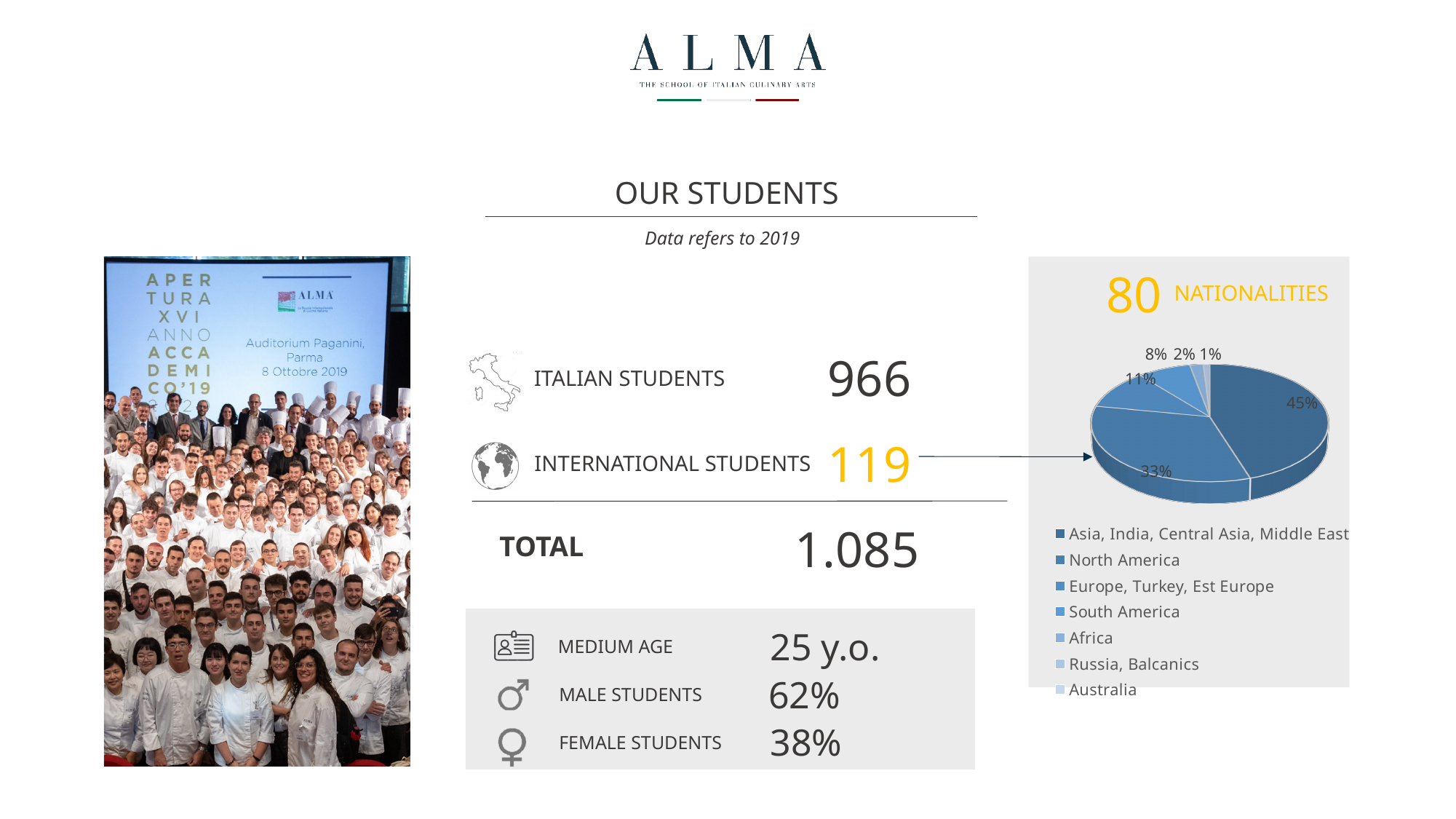
What share of the nationalities pie chart is 'North America'? 33% What is the difference in percentage points between the 'Asia, India, Central Asia, Middle East' slice and the 'North America' slice? 12 Which category has the largest slice in the nationalities pie chart? Asia, India, Central Asia, Middle East What share of the nationalities pie chart is 'South America'? 8% What number is shown in yellow above the nationalities pie chart? 80 Which slice is larger in the nationalities pie chart: 'Europe, Turkey, Est Europe' or 'South America'? Europe, Turkey, Est Europe What share of the nationalities pie chart is 'Africa'? 2% What share of the nationalities pie chart is 'Asia, India, Central Asia, Middle East'? 45% How many categories does the legend of the nationalities pie chart list? 7 Which legend entry is listed last in the nationalities pie chart? Australia What kind of chart is shown under the '80 NATIONALITIES' heading? pie chart What share of the nationalities pie chart is 'Europe, Turkey, Est Europe'? 11%